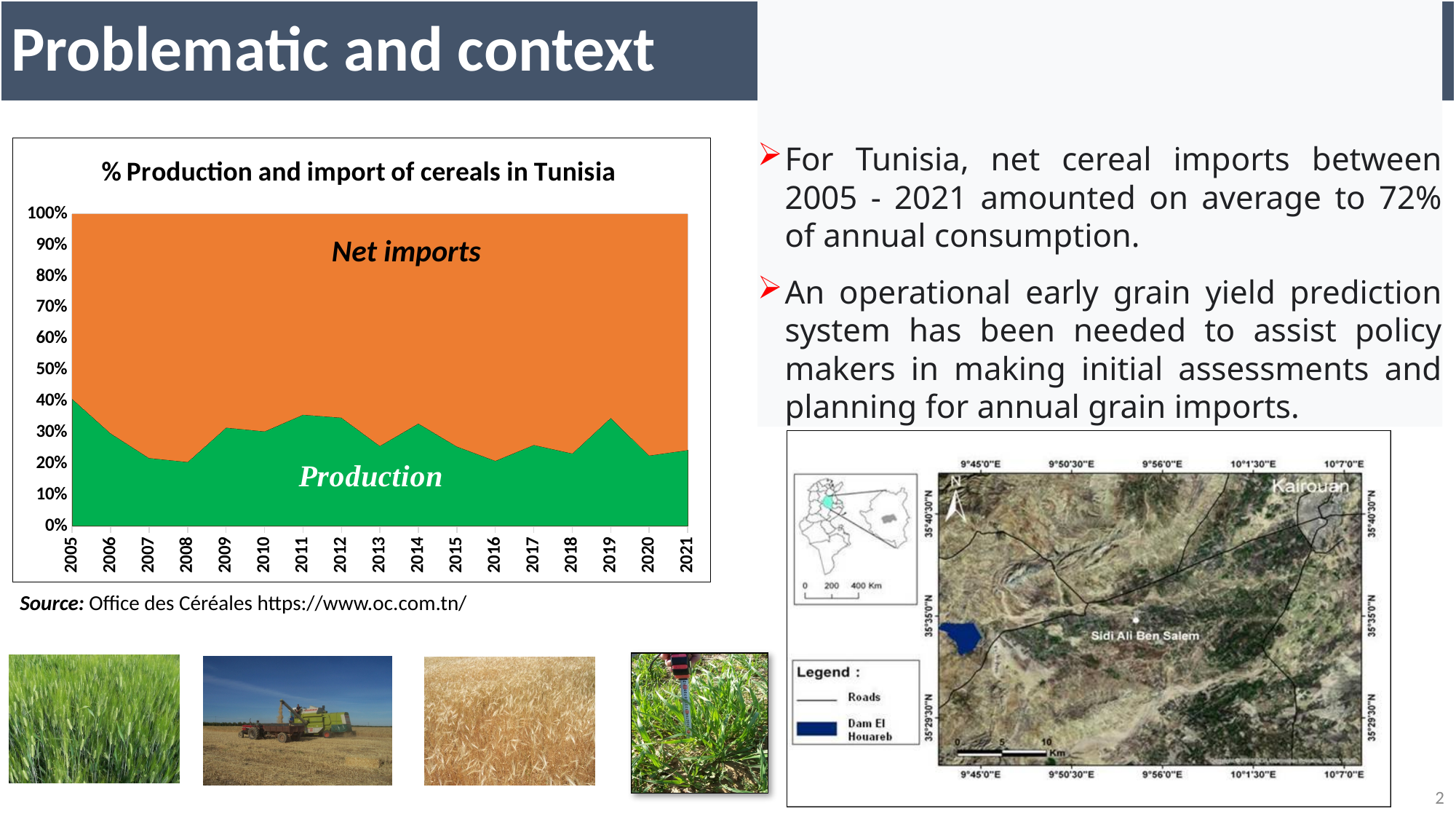
Which year has a larger Production share, 2005 or 2008? 2005 How many years are shown along the x axis of the chart? 17 Is the Production share in 2013 greater or less than 30%? less In which year is the Production share highest? 2005 Does the Production share rise or fall from 2005 to 2008? fall Is the Production share in 2008 greater or less than 30%? less What is the title of the chart? % Production and import of cereals in Tunisia Is the Production share in 2005 greater or less than 30%? greater What type of chart is shown on the slide? Area chart Which series is shown in orange in the chart? Net imports How many series are plotted in the chart? 2